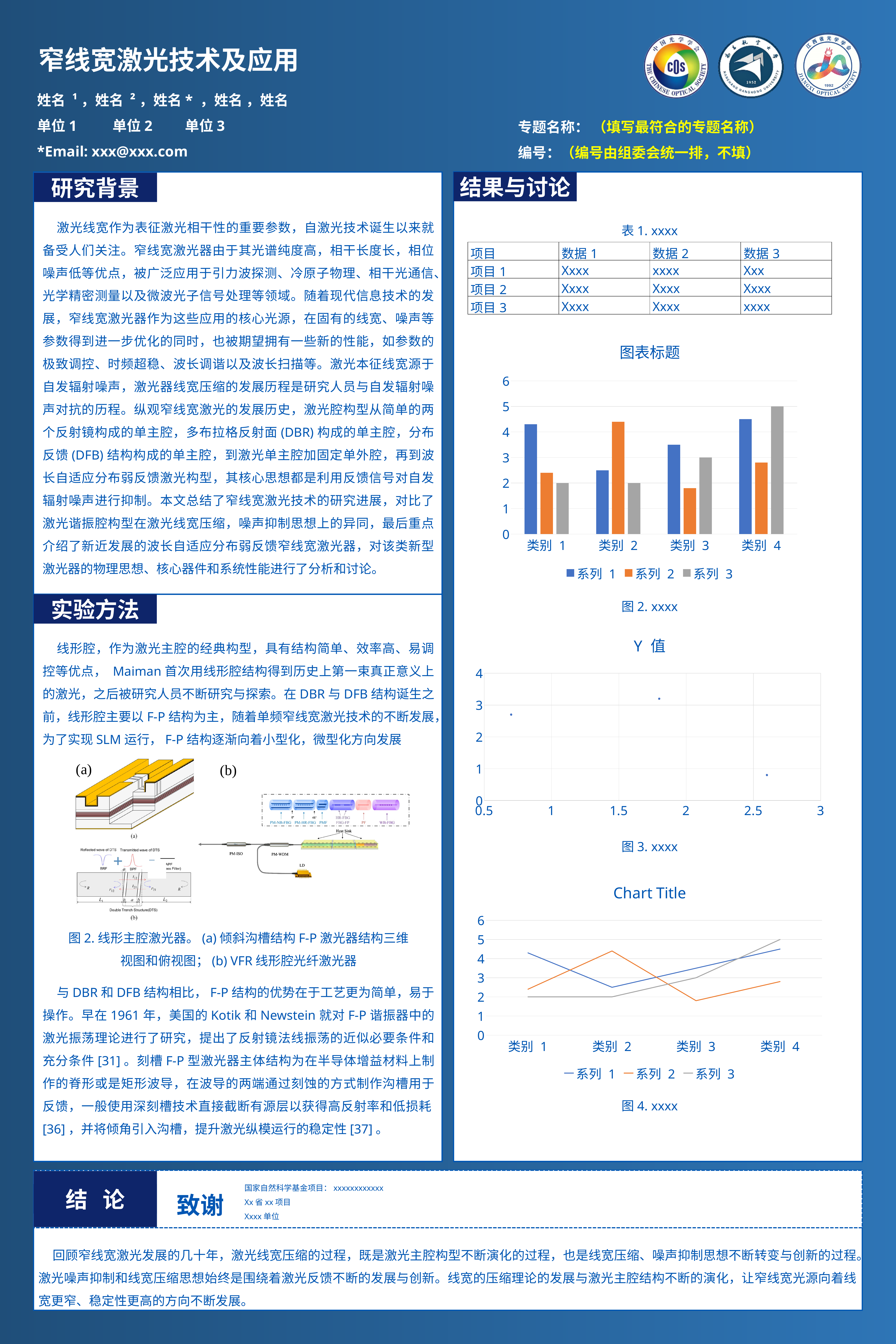
In the chart titled "图表标题", is the value of 系列 1 for 类别 1 greater or less than 3? greater In the chart titled "Chart Title", which category has the lowest value for 系列 2? 类别 3 What kind of chart is the chart titled "图表标题"? bar chart In the chart titled "图表标题", which category has the highest value for 系列 3? 类别 4 In the chart titled "图表标题", how many series does the legend list? 3 In the chart titled "图表标题", how many categories are shown on the x axis? 4 What kind of chart is the chart titled "Chart Title"? line chart How many data points are plotted in the chart titled "Y 值"? 3 In the chart titled "图表标题", for 类别 2, which series has the larger value, 系列 1 or 系列 2? 系列 2 In the chart titled "图表标题", what is the value of 系列 3 for 类别 4? 5 What kind of chart is the chart titled "Y 值"? scatter chart In the chart titled "Chart Title", is the value of 系列 2 for 类别 3 greater or less than 3? less